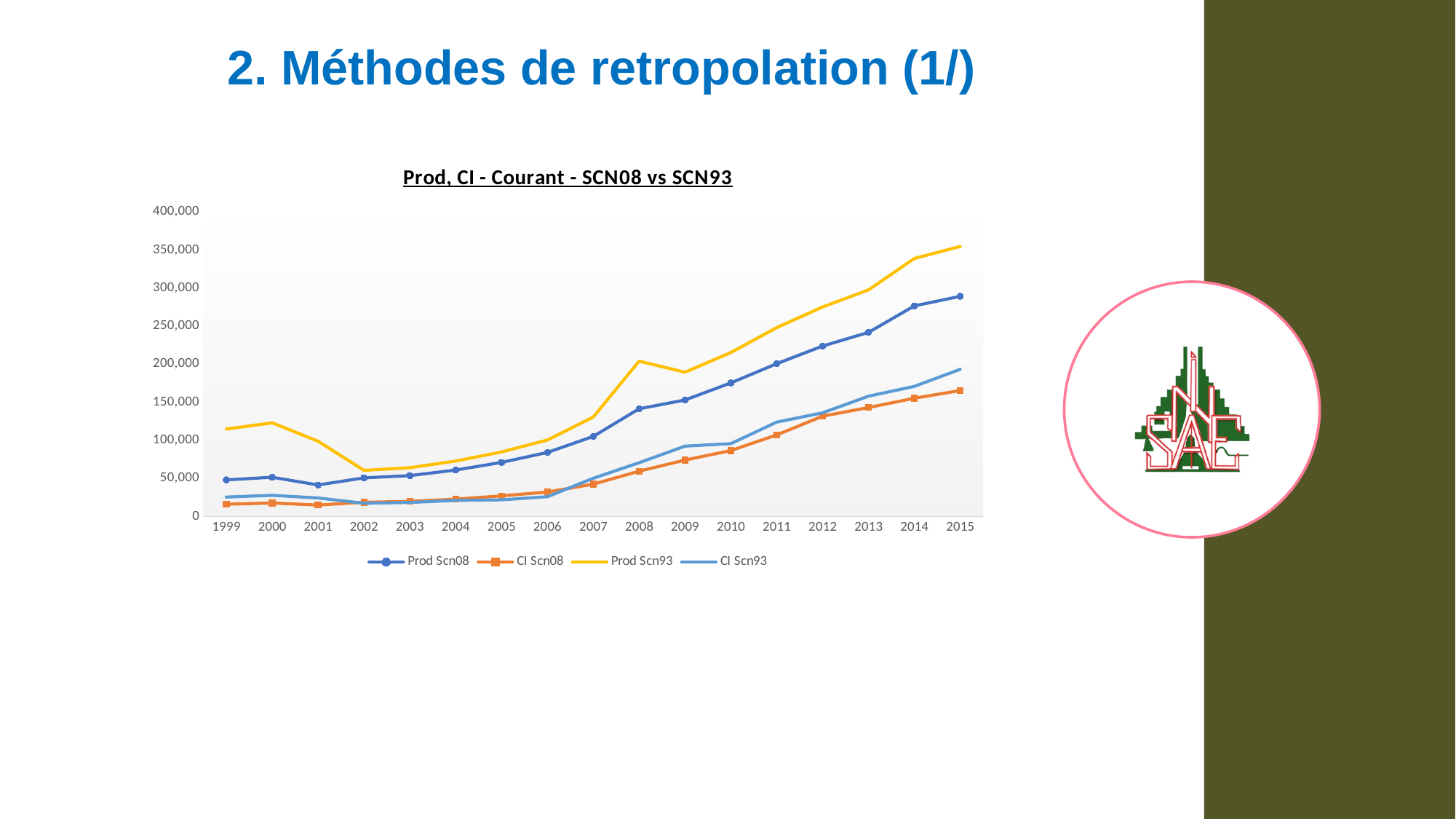
How many years are shown on the x axis of the chart? 17 How many series does the legend of the chart list? 4 In 2009, which is larger: CI Scn93 or CI Scn08? CI Scn93 Which series has the lowest value in 2015? CI Scn08 Which series is plotted in yellow in the chart? Prod Scn93 Is the value for Prod Scn93 in 2015 greater or less than 300,000? greater What kind of chart is shown on the slide? line chart Is the value for Prod Scn08 in 2015 greater or less than 300,000? less Does the Prod Scn08 series rise or fall from 2002 to 2015? rise What is the title of the chart? Prod, CI - Courant - SCN08 vs SCN93 Which series has the highest value in 2015? Prod Scn93 Is the value for Prod Scn93 in 2008 greater or less than 150,000? greater